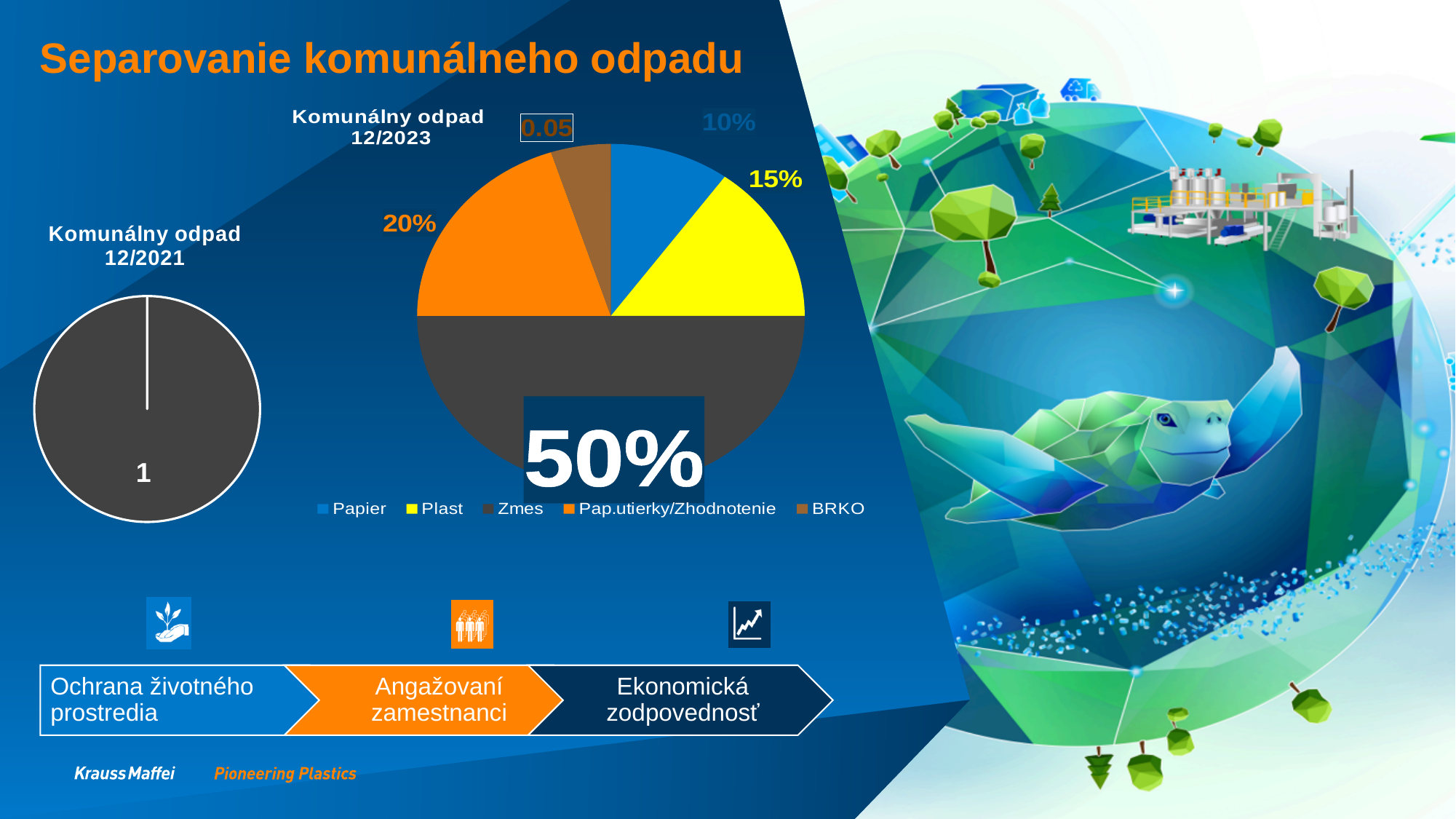
In the 'Komunálny odpad 12/2023' chart, what is the value for Papier? 10% In the 'Komunálny odpad 12/2023' chart, what is the value for Zmes? 50% How many categories does the legend of the 'Komunálny odpad 12/2023' chart list? 5 In the 'Komunálny odpad 12/2023' chart, what is the value labelled for BRKO? 0.05 In the 'Komunálny odpad 12/2023' chart, which category has the smallest slice? BRKO What type of chart is 'Komunálny odpad 12/2021'? Pie chart In the 'Komunálny odpad 12/2023' chart, what is the value for Plast? 15% In the 'Komunálny odpad 12/2023' chart, which category has the largest slice? Zmes In the 'Komunálny odpad 12/2023' chart, which is larger: Plast or Papier? Plast In the 'Komunálny odpad 12/2023' chart, what is the value for Pap.utierky/Zhodnotenie? 20% What value is labelled on the single slice of the 'Komunálny odpad 12/2021' chart? 1 In the 'Komunálny odpad 12/2023' chart, what is the difference between Pap.utierky/Zhodnotenie and Papier? 10%